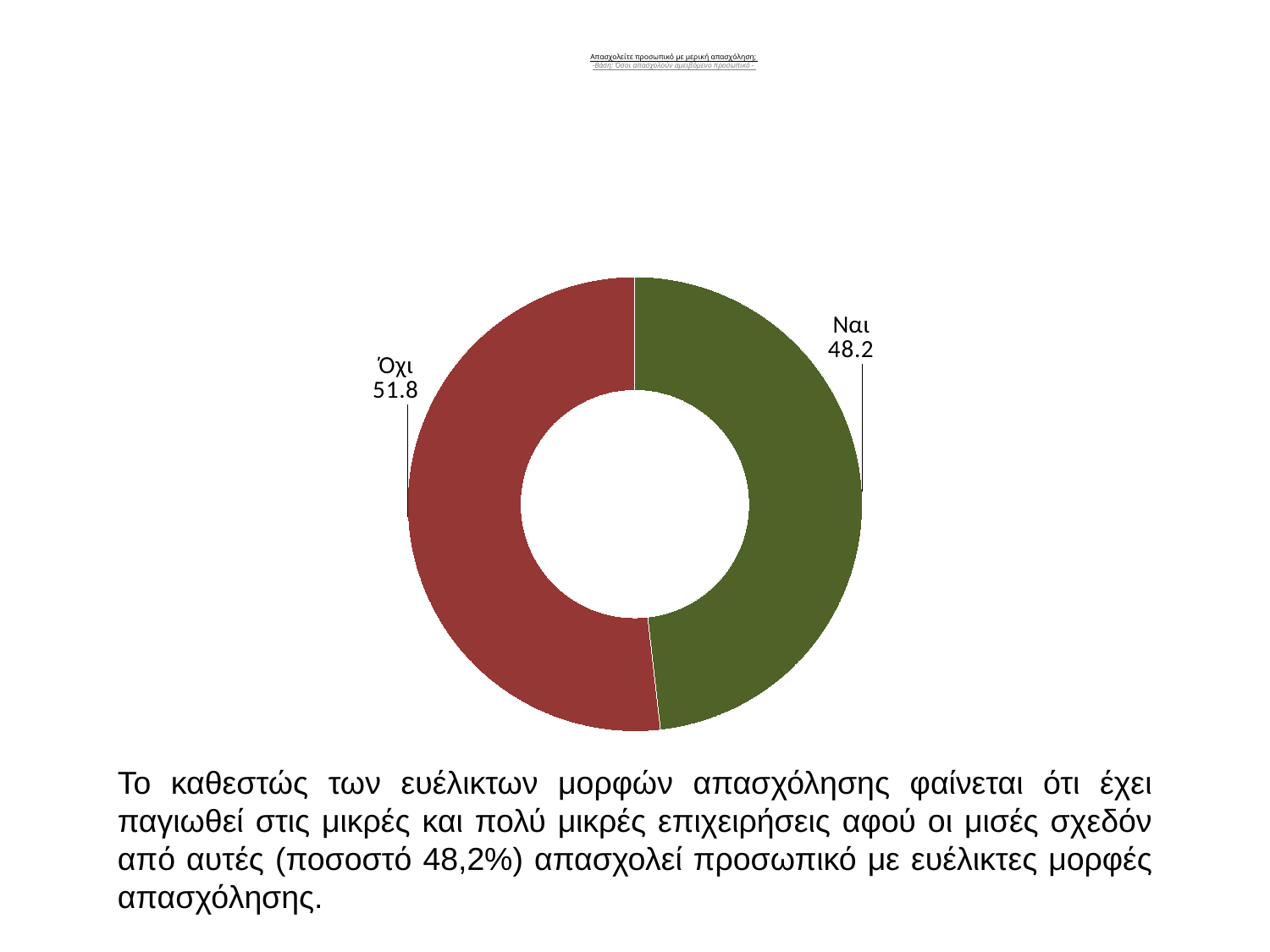
What is the total of the two slice values? 100 What is the difference between the "Όχι" and "Ναι" values? 3.6 How many slices does the chart have? 2 What value is shown for the "Ναι" slice? 48.2 What colour is the "Όχι" slice? Red Which is larger, the "Ναι" slice or the "Όχι" slice? Όχι What value is shown for the "Όχι" slice? 51.8 What colour is the "Ναι" slice? Green Which slice is the smallest? Ναι Which slice is the largest? Όχι What kind of chart is shown on the slide? Doughnut (pie) chart